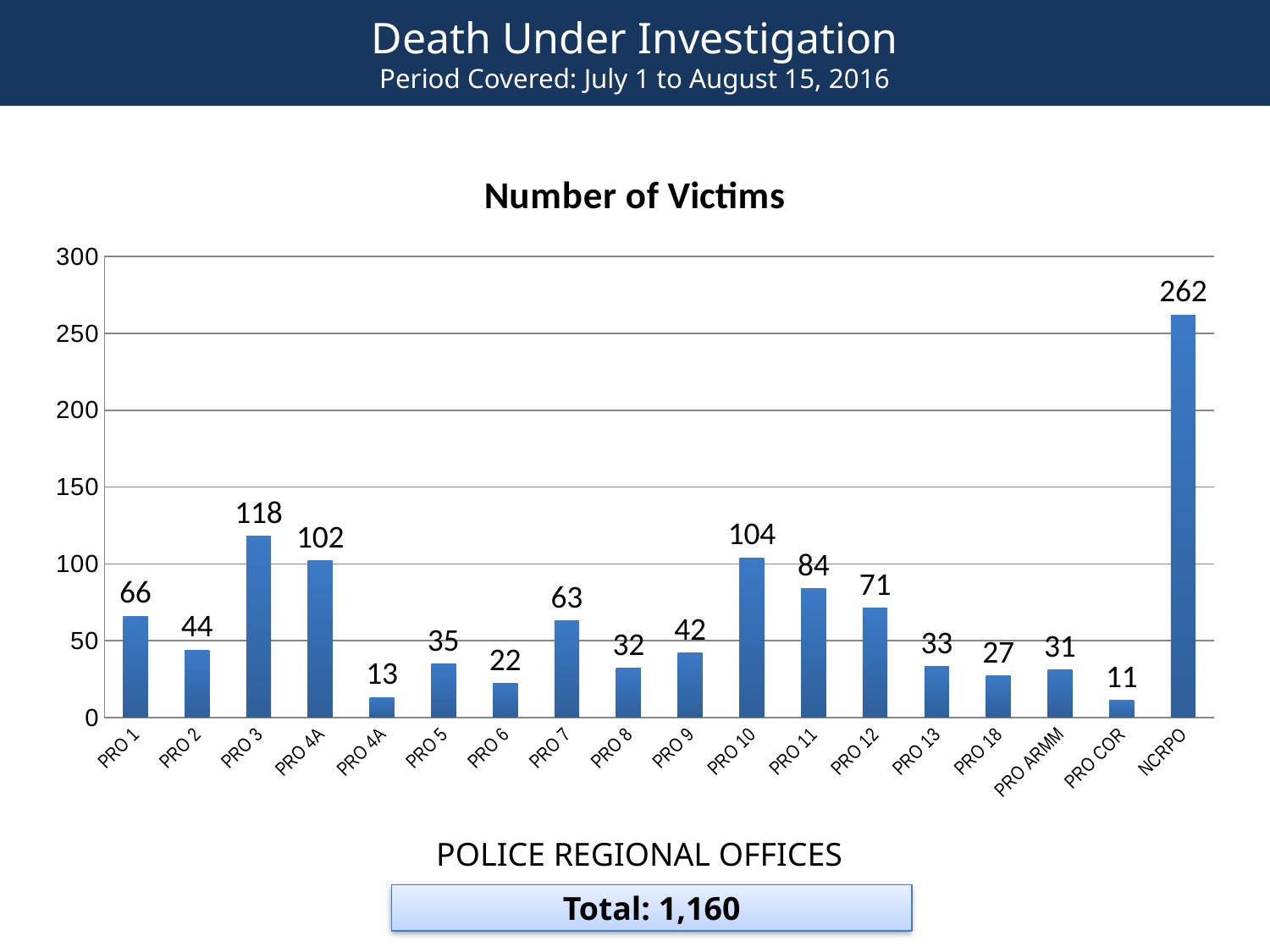
Which police regional office has the highest number of victims? NCRPO What is the title of the chart? Number of Victims What is the number of victims for PRO COR? 11 Which police regional office has the lowest number of victims? PRO COR What is the difference in number of victims between PRO 3 and PRO 11? 34 Which has more victims, PRO 7 or PRO 12? PRO 12 What is the number of victims for NCRPO? 262 What is the number of victims for PRO 10? 104 What kind of chart is shown on the slide? Bar chart How many police regional offices are shown on the chart? 18 Is the value for PRO 1 greater or less than 50? greater What is the total number of victims shown below the chart? 1,160